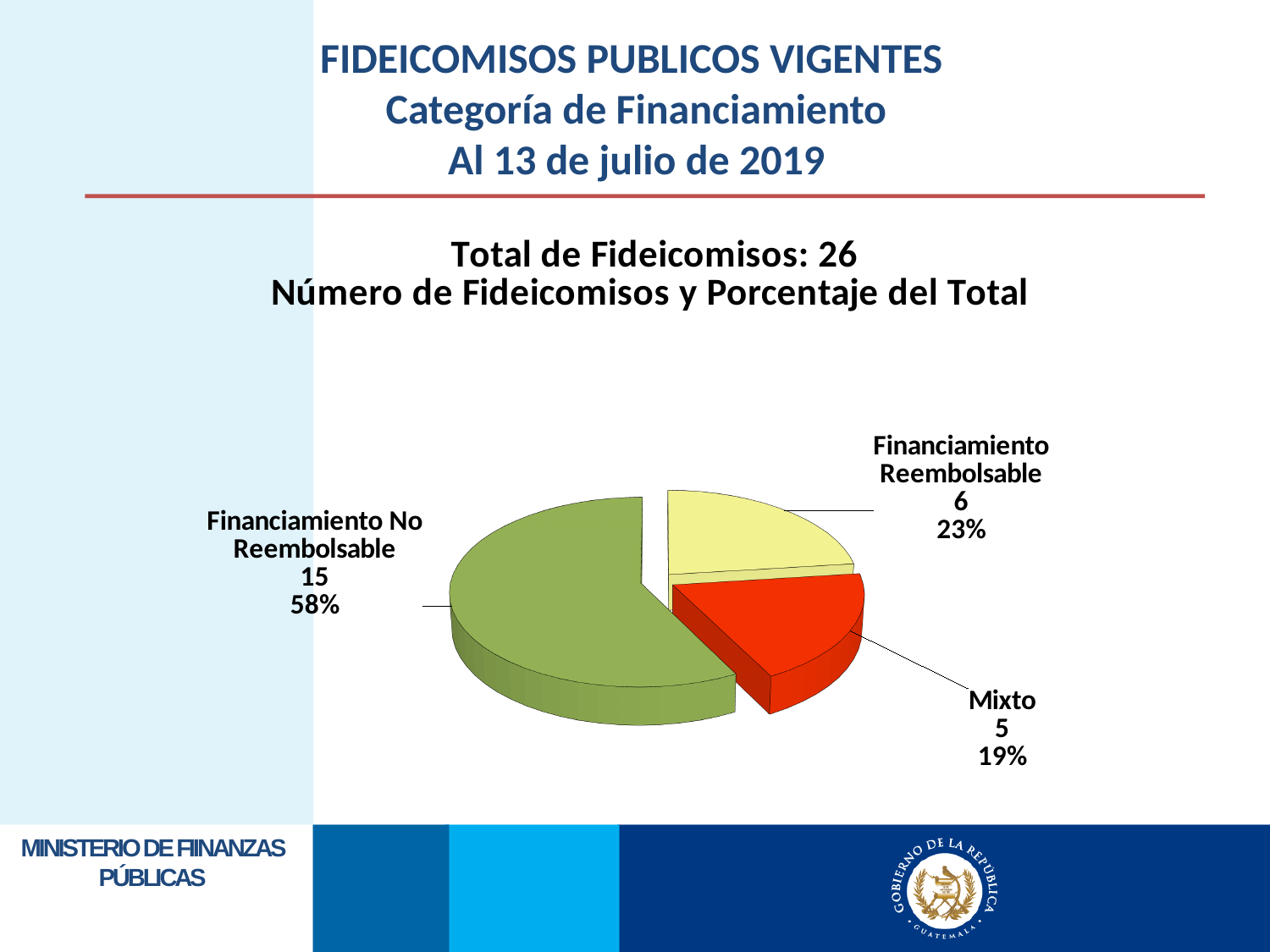
What is the total number of fideicomisos stated on the slide? 26 How many fideicomisos are in the Mixto category? 5 Which category has the largest number of fideicomisos? Financiamiento No Reembolsable How many more fideicomisos are in Financiamiento No Reembolsable than in Financiamiento Reembolsable? 9 What percentage of the total does Financiamiento Reembolsable represent? 23% Which category has the smallest number of fideicomisos? Mixto What kind of chart is shown on the slide? pie chart What colour is the Mixto slice of the pie? red How many categories does the pie chart show? 3 How many fideicomisos are in the Financiamiento No Reembolsable category? 15 What share of the pie does Mixto account for? 19% Which has more fideicomisos, Financiamiento Reembolsable or Mixto? Financiamiento Reembolsable